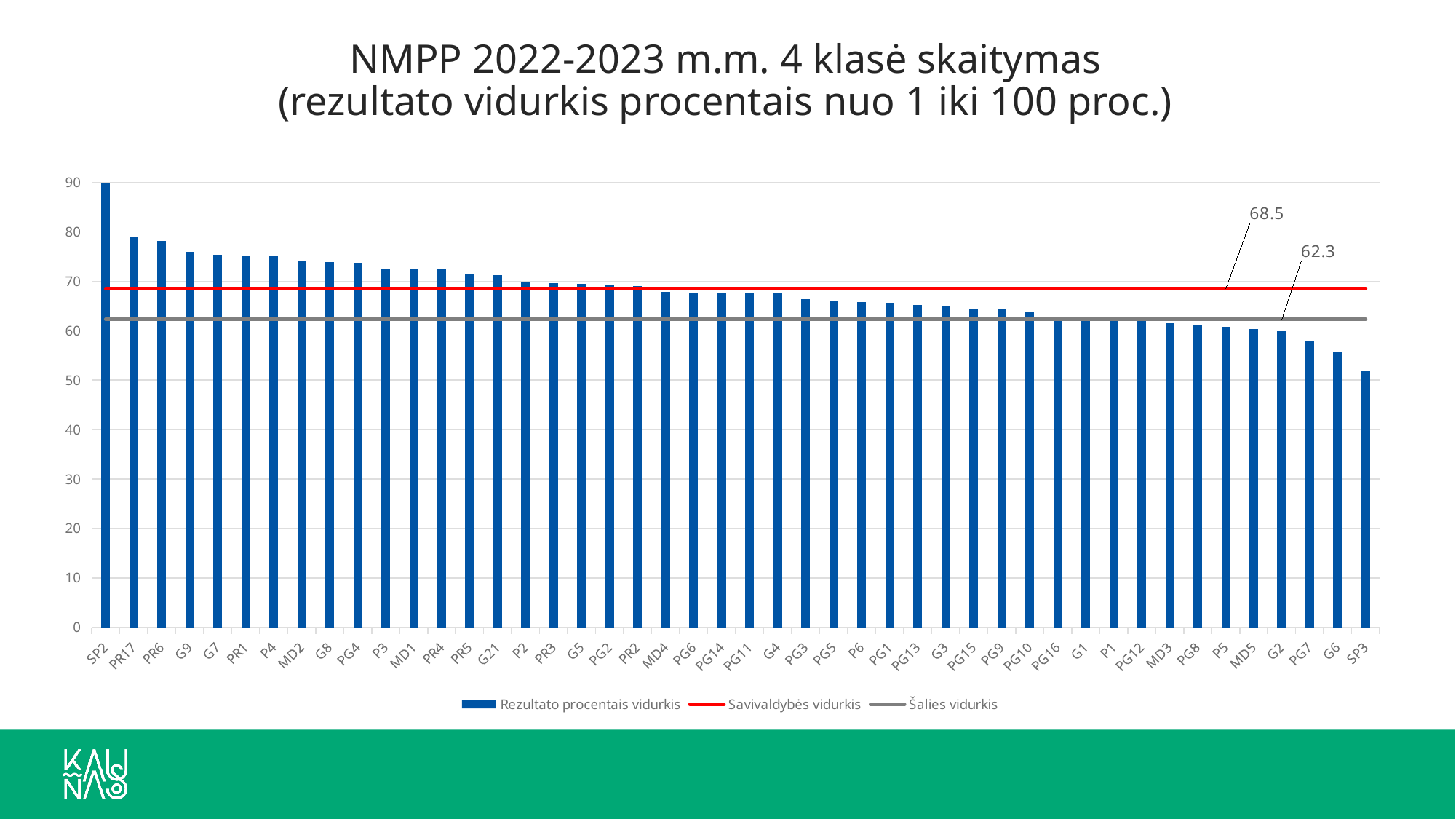
Is the value for G6 greater or less than 60? less How many schools (categories) are plotted on the x axis? 46 What is the value of the Savivaldybės vidurkis line? 68.5 Is the value for SP2 greater or less than 80? greater Which school has the lowest result average? SP3 What is the value of the Šalies vidurkis line? 62.3 Which school has the highest result average? SP2 Which is larger, the value for PR17 or the value for G2? PR17 Is the value for SP3 greater or less than 60? less What type of chart is shown on the slide? combination bar and line chart How many series does the legend list? 3 Do the bar values rise or fall from left to right along the x axis? fall